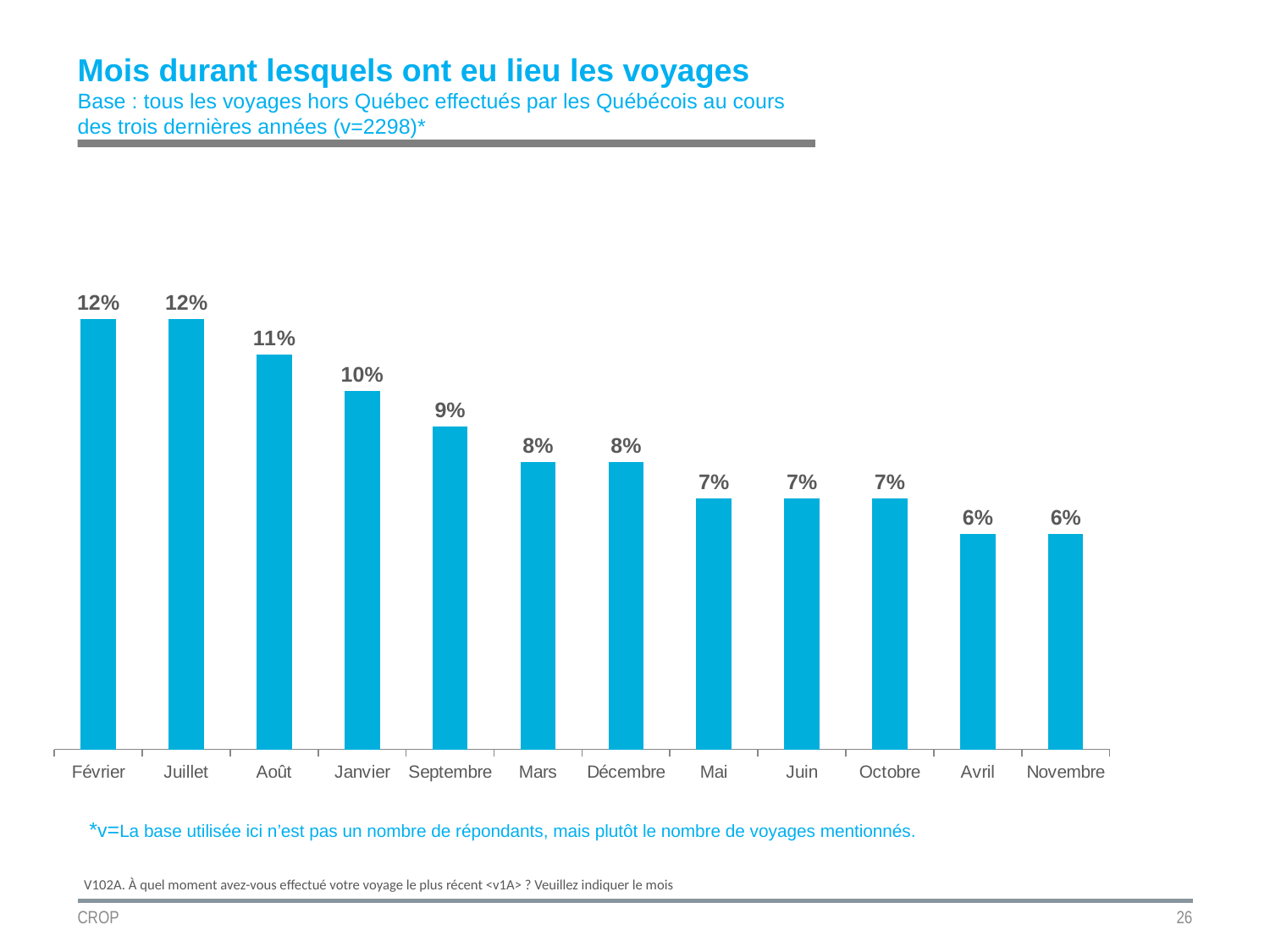
Do the values rise or fall from left to right along the x axis? Fall What is the lowest value shown on the chart? 6% What is the difference between the values for Février and Novembre? 6% Which is larger, the value for Août or the value for Décembre? Août What is the value for Octobre? 7% What is the value for Août? 11% What kind of chart is shown on the slide? Bar chart What is the value for Septembre? 9% How many months are shown on the chart? 12 What is the difference between the values for Janvier and Mars? 2% What is the value for Janvier? 10% Which two months share the highest value on the chart? Février and Juillet